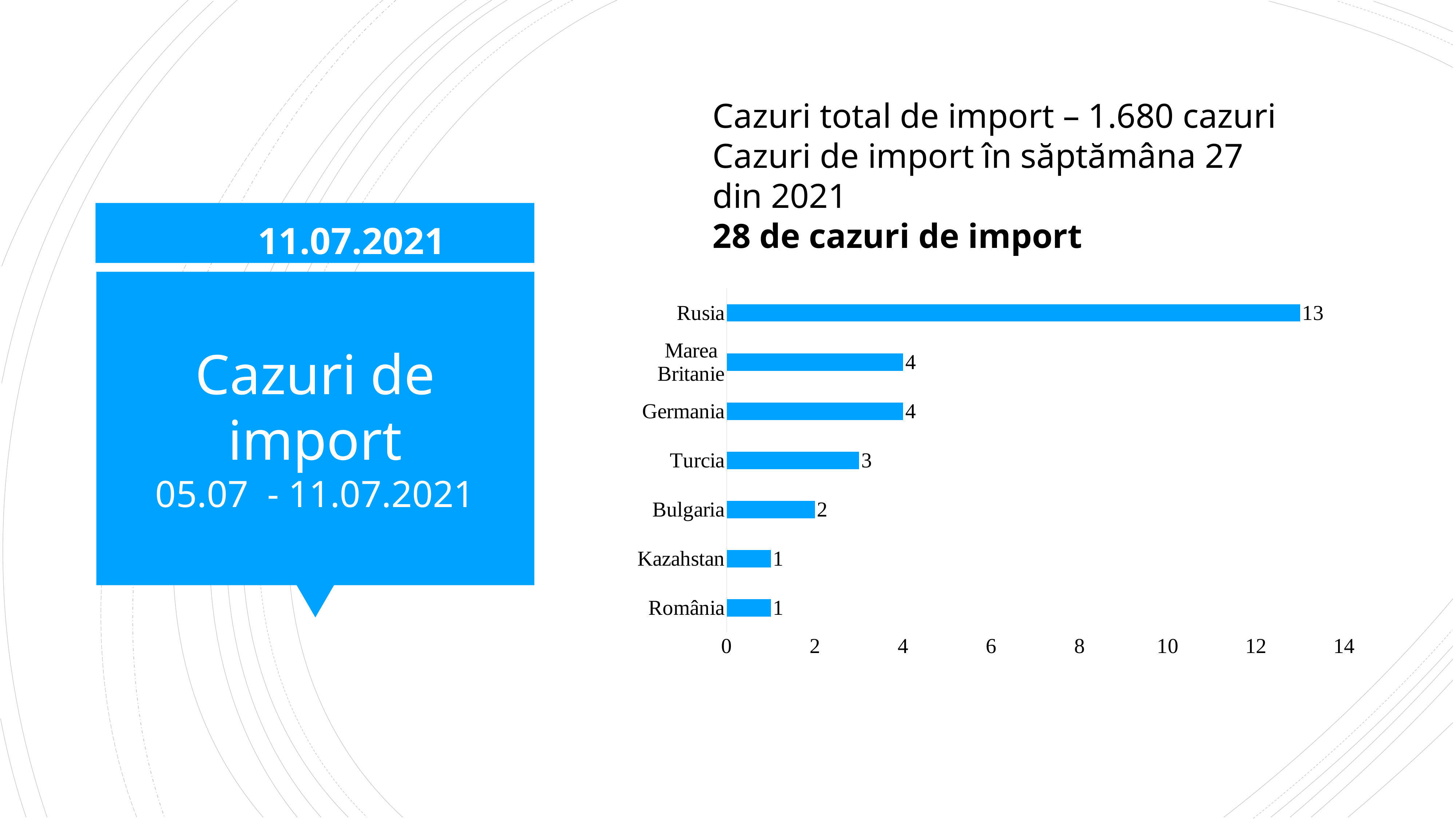
What is the difference between the values for Rusia and Germania? 9 Which category has the highest value? Rusia Is the value for Rusia greater or less than 12? greater What is the value for Rusia? 13 What is the value for Turcia? 3 What is the difference between the values for Marea Britanie and Kazahstan? 3 What kind of chart is shown on the slide? bar chart What is the value for Bulgaria? 2 What is the value for Marea Britanie? 4 How many categories are shown in the chart? 7 Which is larger, the value for Turcia or the value for Bulgaria? Turcia What is the highest value shown on the horizontal axis? 14